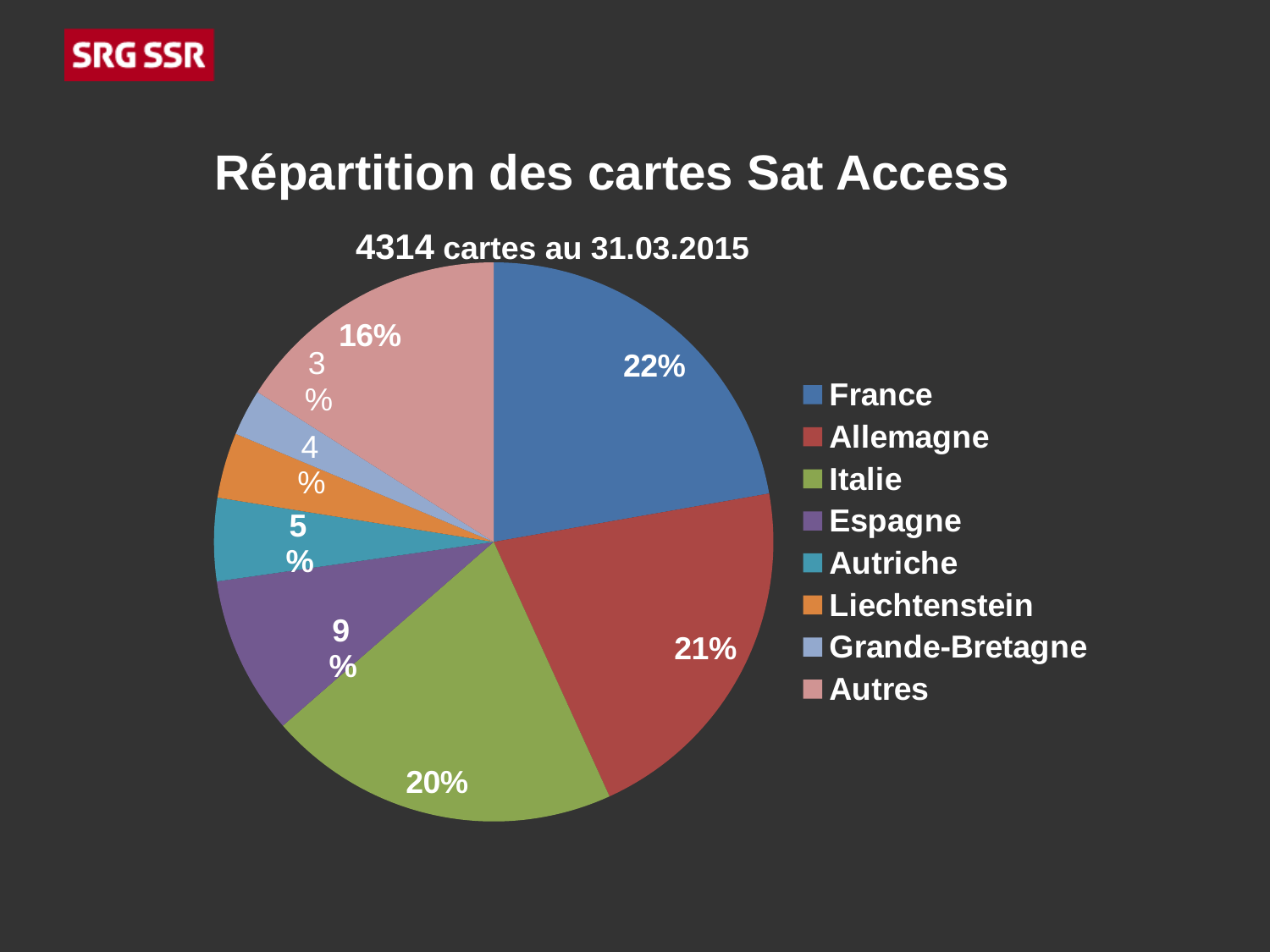
What kind of chart is shown on the slide? Pie chart What share of the pie does Espagne have? 9% Which category has the largest slice of the pie? France What share of the pie does Autres have? 16% How many categories does the legend list? 8 What share of the pie does France have? 22% Which has a larger share, Autriche or Liechtenstein? Autriche What share of the pie does Allemagne have? 21% Which category has the smallest slice of the pie? Grande-Bretagne What is the difference in percentage points between France and Espagne? 13 What share of the pie does Italie have? 20%